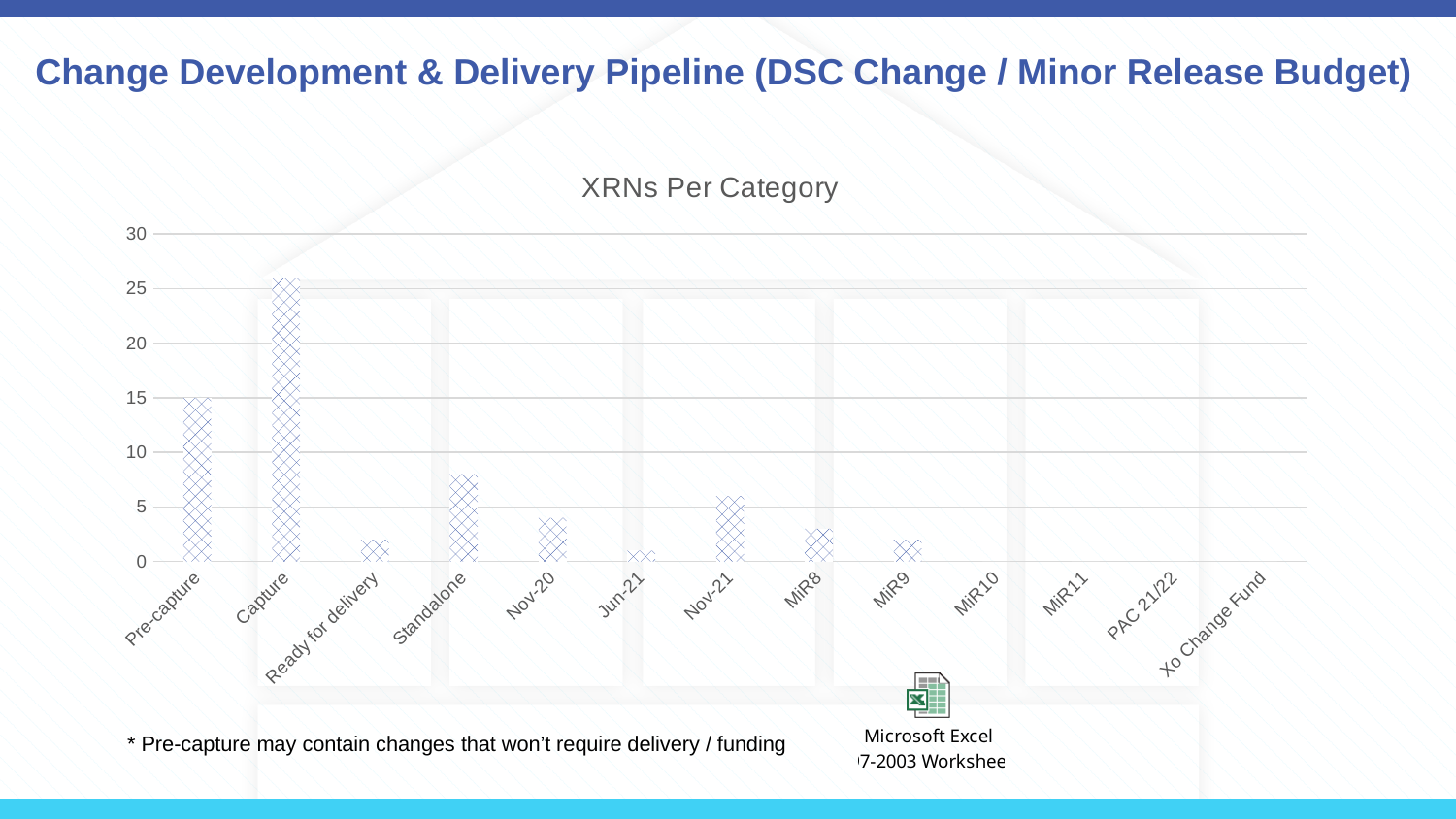
Which category has the highest value in the chart? Capture Is the value for Standalone greater or less than 10? less Which is larger, the value for Nov-21 or the value for Nov-20? Nov-21 What is the title of the chart? XRNs Per Category What is the value for Pre-capture? 15 What kind of chart is shown on the slide? bar chart How many categories are shown on the x axis of the chart? 13 Is the value for Jun-21 greater or less than 5? less Is the value for Capture greater or less than 20? greater Which is larger, the value for Pre-capture or the value for Standalone? Pre-capture